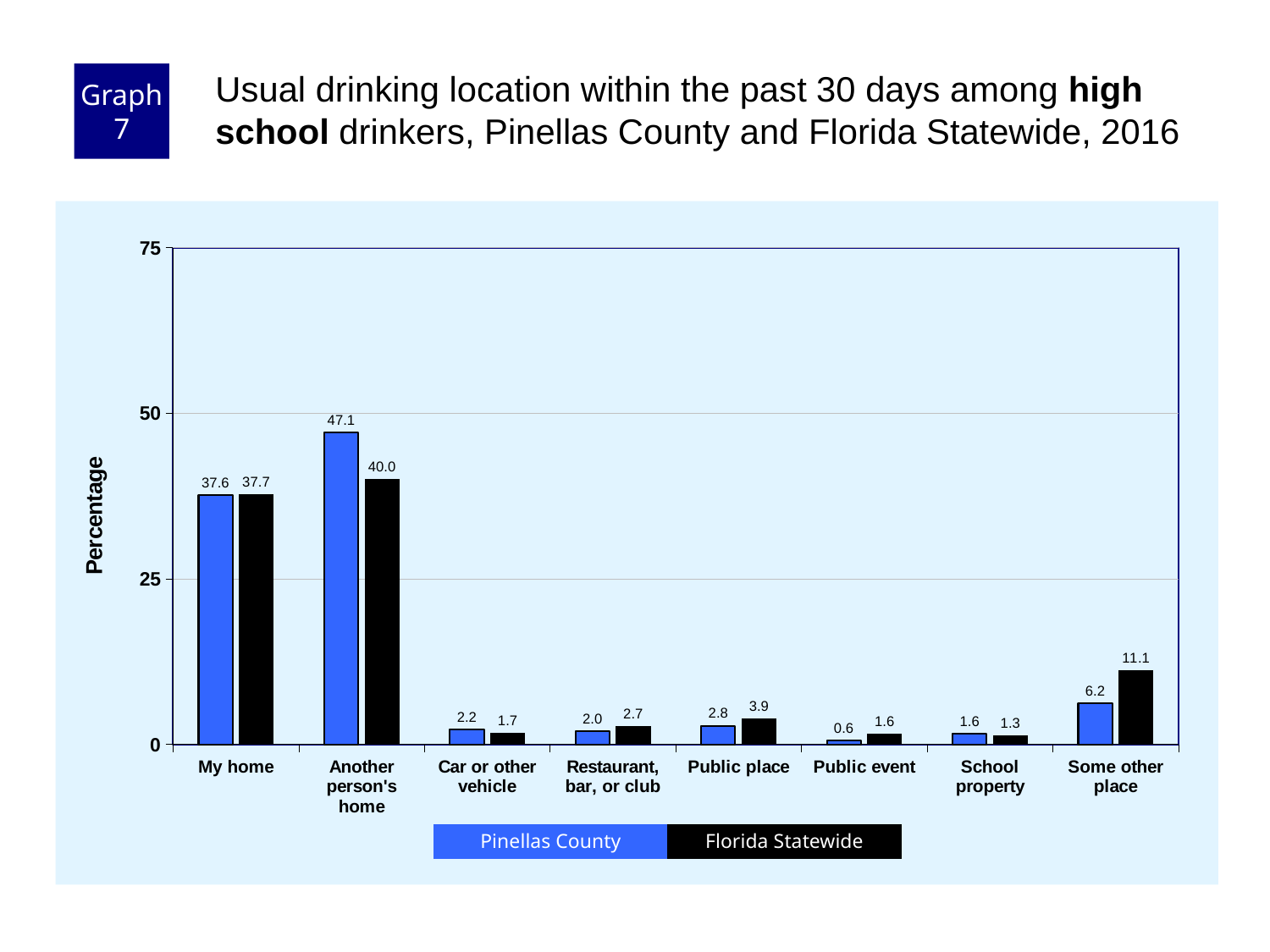
What is the Florida Statewide value for "Some other place"? 11.1 What is the difference between the Pinellas County and Florida Statewide values for "Another person's home"? 7.1 Which is larger for "Public place": Pinellas County or Florida Statewide? Florida Statewide Which category has the highest Pinellas County value? Another person's home Which category has the lowest Florida Statewide value? School property What is the label of the y axis? Percentage What type of chart is shown on the slide? Bar chart How many drinking location categories are shown on the x axis? 8 Is the Florida Statewide value for "My home" greater or less than 25? greater What is the Pinellas County value for "Public event"? 0.6 What is the Pinellas County value for "Another person's home"? 47.1 How many series does the legend list? 2